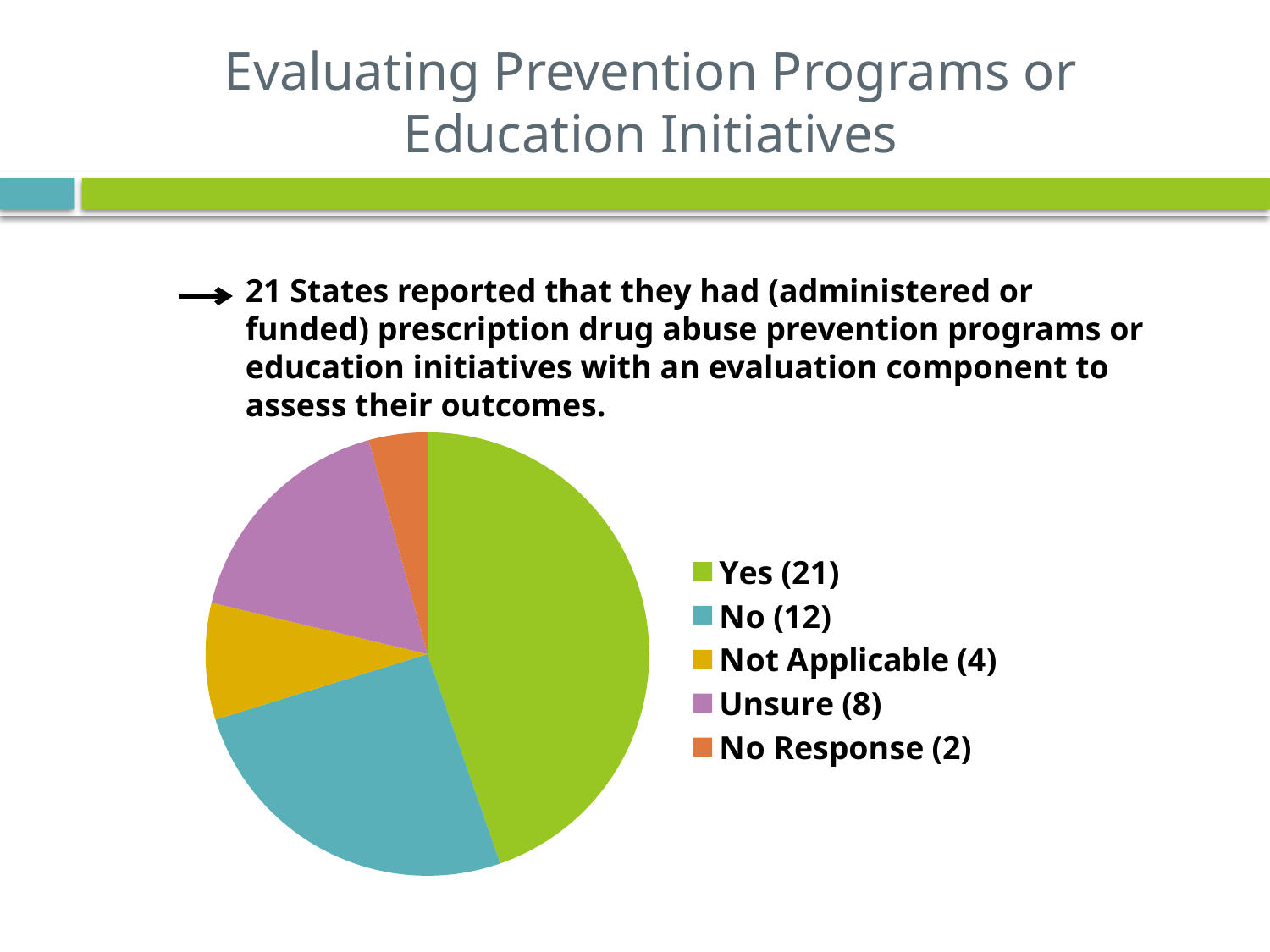
What type of chart is shown on the slide? Pie chart Which category has the largest slice of the pie chart? Yes (21) What colour represents the "No" category in the pie chart? Teal (blue-green) How many states responded "Yes" according to the pie chart legend? 21 What is the value for "Unsure" in the pie chart? 8 How many categories are shown in the pie chart? 5 What is the difference between the number of "Yes" responses and "No" responses? 9 How many states responded "No" according to the pie chart legend? 12 What is the value for "Not Applicable" in the pie chart? 4 Which is larger: the "Unsure" slice or the "Not Applicable" slice? Unsure What is the value for "No Response" in the pie chart? 2 Which category has the smallest slice of the pie chart? No Response (2)